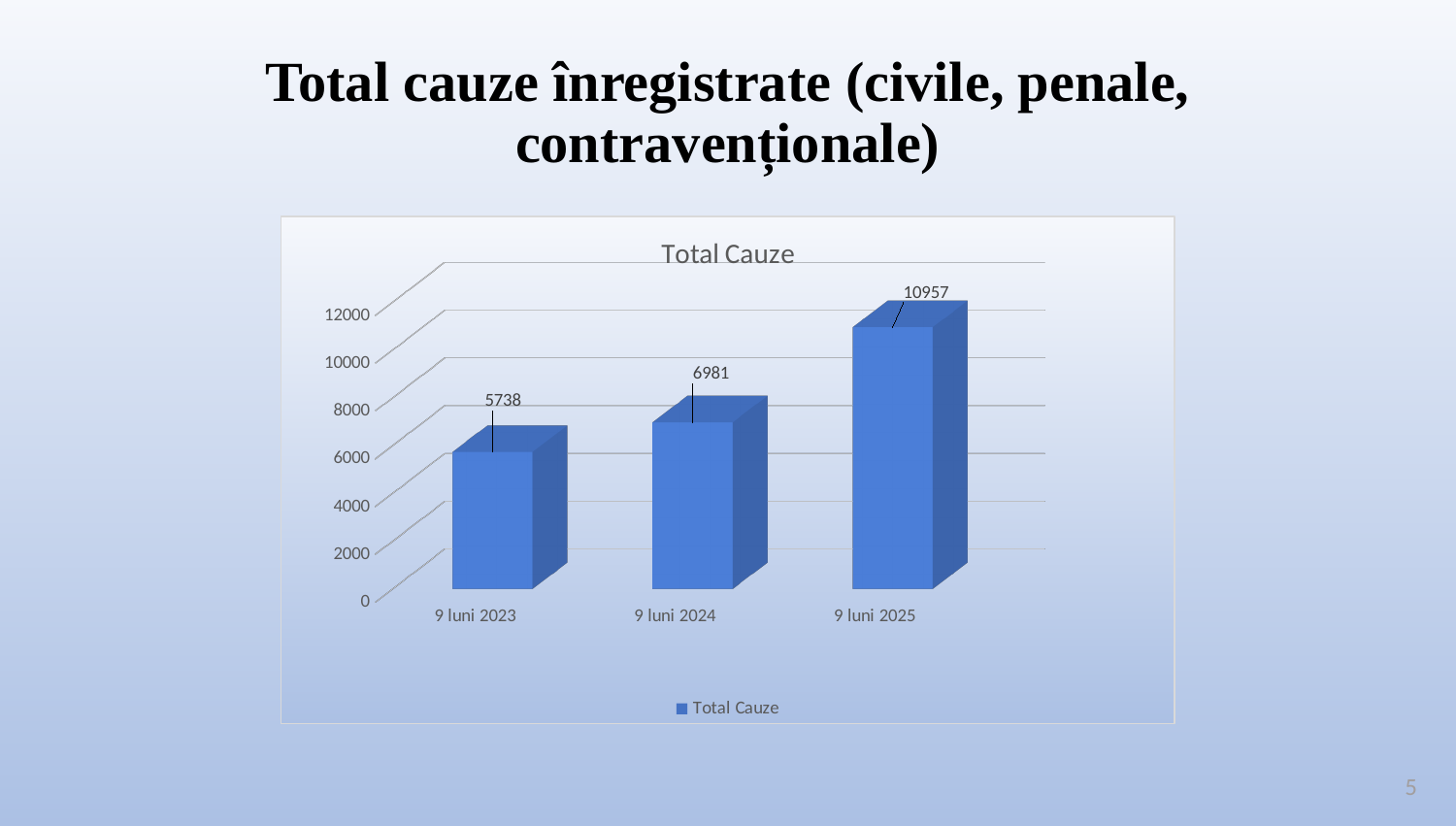
Which category has the highest value? 9 luni 2025 What kind of chart is shown? bar chart Do the values rise or fall from 9 luni 2023 to 9 luni 2025? rise How many categories are shown on the x axis? 3 What is the difference between the values for 9 luni 2025 and 9 luni 2024? 3976 What is the value for 9 luni 2023? 5738 What is the difference between the values for 9 luni 2024 and 9 luni 2023? 1243 What is the value for 9 luni 2025? 10957 Is the value for 9 luni 2025 greater or less than 10000? greater What is the value for 9 luni 2024? 6981 Which is larger, the value for 9 luni 2024 or the value for 9 luni 2023? 9 luni 2024 Which category has the lowest value? 9 luni 2023